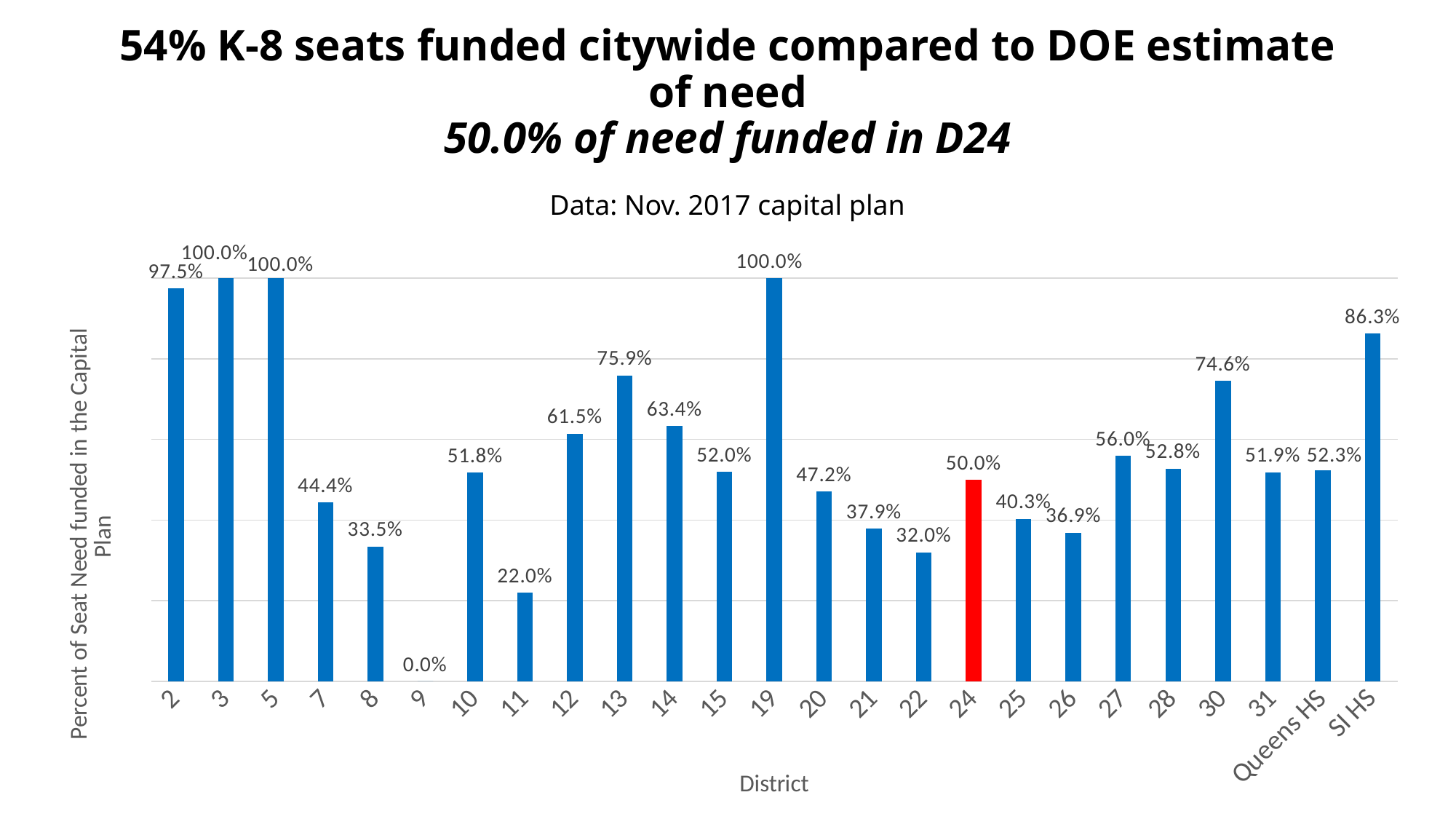
What is the difference between the values for District 30 and District 24? 24.6% What is the value shown for SI HS? 86.3% What type of chart is shown on the slide? Bar chart What is the difference between the values for District 2 and District 8? 64.0% What percent of seat need is funded in the capital plan for District 24? 50.0% Which has a larger value, District 12 or District 14? District 14 What is the value shown for District 13? 75.9% Which district has the lowest percent of seat need funded? 9 Which districts have the highest value, 100.0%? 3, 5 and 19 Which has a larger value, District 21 or District 26? District 21 What is the value shown for District 11? 22.0% How many districts (categories) are shown on the x axis? 25